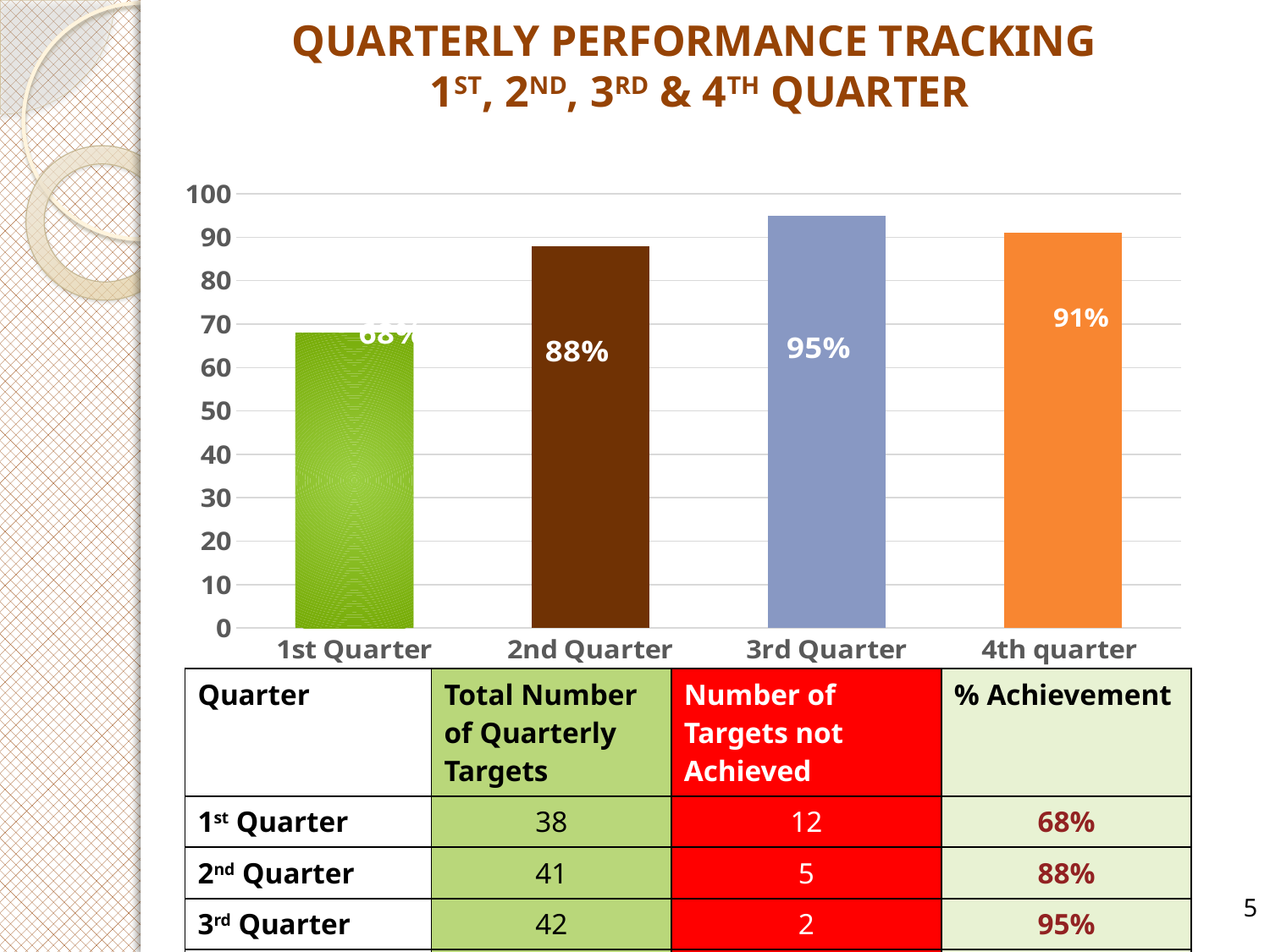
Is the value for the 1st Quarter greater or less than 70? less What is the difference between the 3rd Quarter value and the 2nd Quarter value? 7% Which quarter has the highest bar in the chart? 3rd Quarter What is the difference between the 4th quarter value and the 1st Quarter value? 23% What is the title of the slide containing the chart? QUARTERLY PERFORMANCE TRACKING 1ST, 2ND, 3RD & 4TH QUARTER What is the value shown for the 3rd Quarter bar? 95% What kind of chart is shown on the slide? bar chart What is the value shown for the 4th quarter bar? 91% Which quarter has the lowest bar in the chart? 1st Quarter How many quarters are plotted in the chart? 4 What is the value shown for the 2nd Quarter bar? 88% Which is larger, the value for the 4th quarter or the value for the 2nd Quarter? 4th quarter